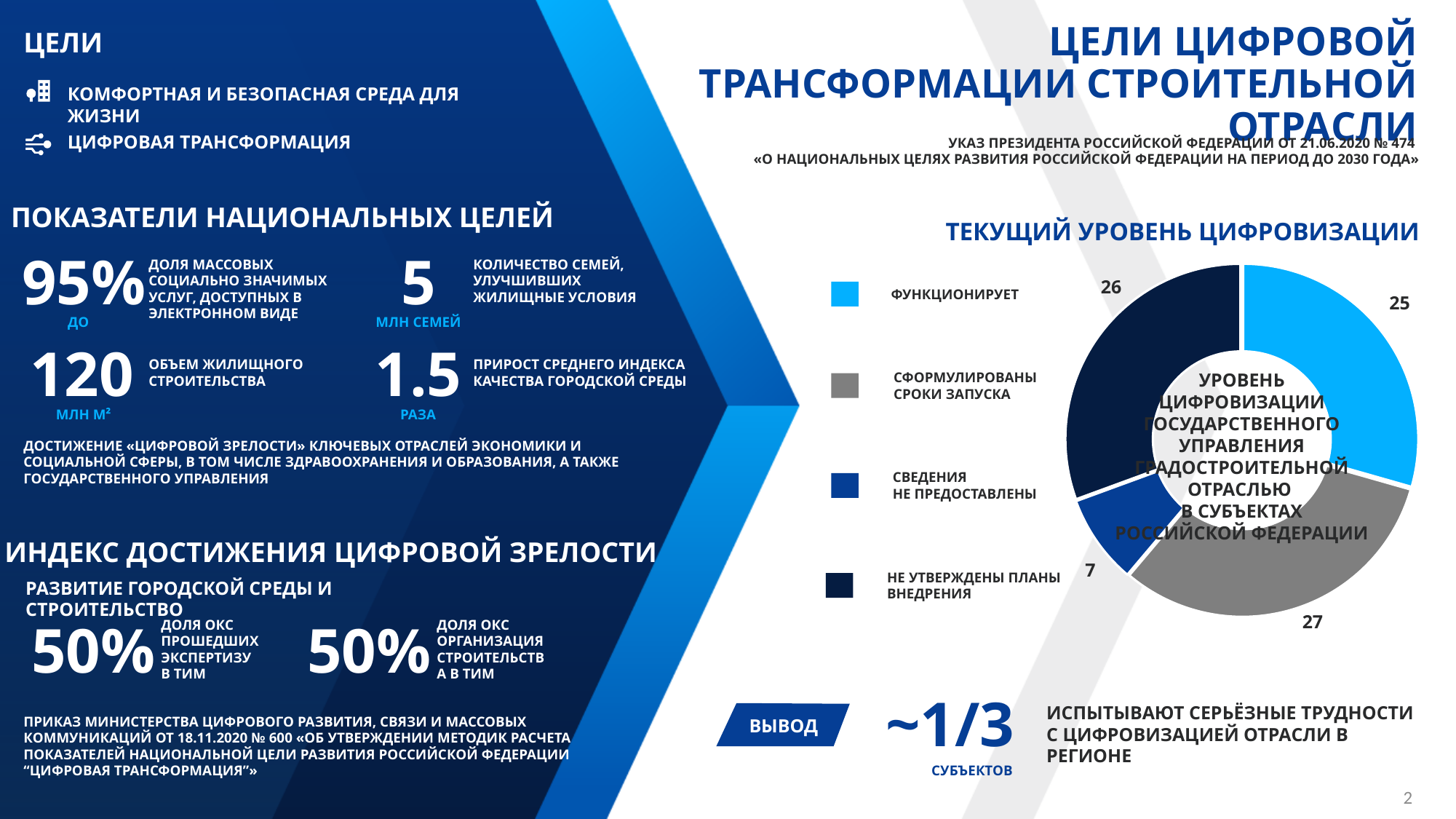
In the doughnut chart, what is the value for «СВЕДЕНИЯ НЕ ПРЕДОСТАВЛЕНЫ»? 7 In the doughnut chart, which is larger: «ФУНКЦИОНИРУЕТ» or «СВЕДЕНИЯ НЕ ПРЕДОСТАВЛЕНЫ»? ФУНКЦИОНИРУЕТ How many categories does the doughnut chart show? 4 What type of chart is shown under the heading «ТЕКУЩИЙ УРОВЕНЬ ЦИФРОВИЗАЦИИ»? Doughnut (pie) chart What is the total of all values in the doughnut chart? 85 In the doughnut chart, what is the value for «СФОРМУЛИРОВАНЫ СРОКИ ЗАПУСКА»? 27 Which category in the doughnut chart has the smallest value? СВЕДЕНИЯ НЕ ПРЕДОСТАВЛЕНЫ In the doughnut chart, what is the value for «ФУНКЦИОНИРУЕТ»? 25 In the doughnut chart, what is the difference between «СФОРМУЛИРОВАНЫ СРОКИ ЗАПУСКА» and «СВЕДЕНИЯ НЕ ПРЕДОСТАВЛЕНЫ»? 20 Which category in the doughnut chart has the largest value? СФОРМУЛИРОВАНЫ СРОКИ ЗАПУСКА In the doughnut chart, what is the value for «НЕ УТВЕРЖДЕНЫ ПЛАНЫ ВНЕДРЕНИЯ»? 26 What colour represents «НЕ УТВЕРЖДЕНЫ ПЛАНЫ ВНЕДРЕНИЯ» in the doughnut chart legend? Dark navy blue